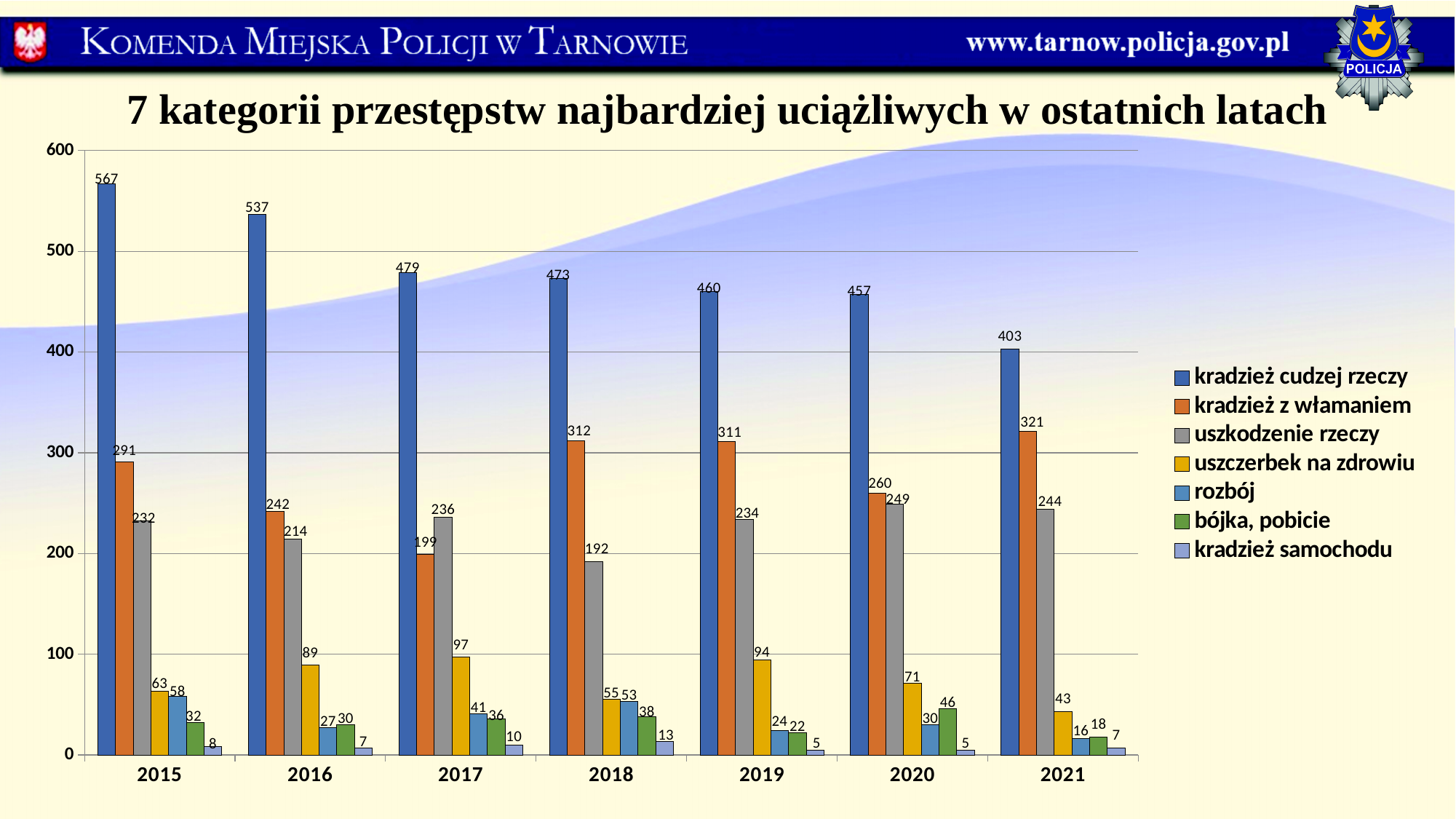
Does the value for kradzież cudzej rzeczy rise or fall from 2015 to 2021? fall In which year is the value for kradzież z włamaniem the highest? 2021 What is the value for uszczerbek na zdrowiu in 2017? 97 How many years are shown on the x axis? 7 What is the value for kradzież z włamaniem in 2021? 321 What is the title of the chart? 7 kategorii przestępstw najbardziej uciążliwych w ostatnich latach What is the value for kradzież cudzej rzeczy in 2015? 567 In which year is the value for kradzież cudzej rzeczy the lowest? 2021 What is the difference between the kradzież cudzej rzeczy values for 2015 and 2021? 164 Which is larger in 2017: uszkodzenie rzeczy or kradzież z włamaniem? uszkodzenie rzeczy What type of chart is shown on the slide? bar chart How many series does the legend list? 7